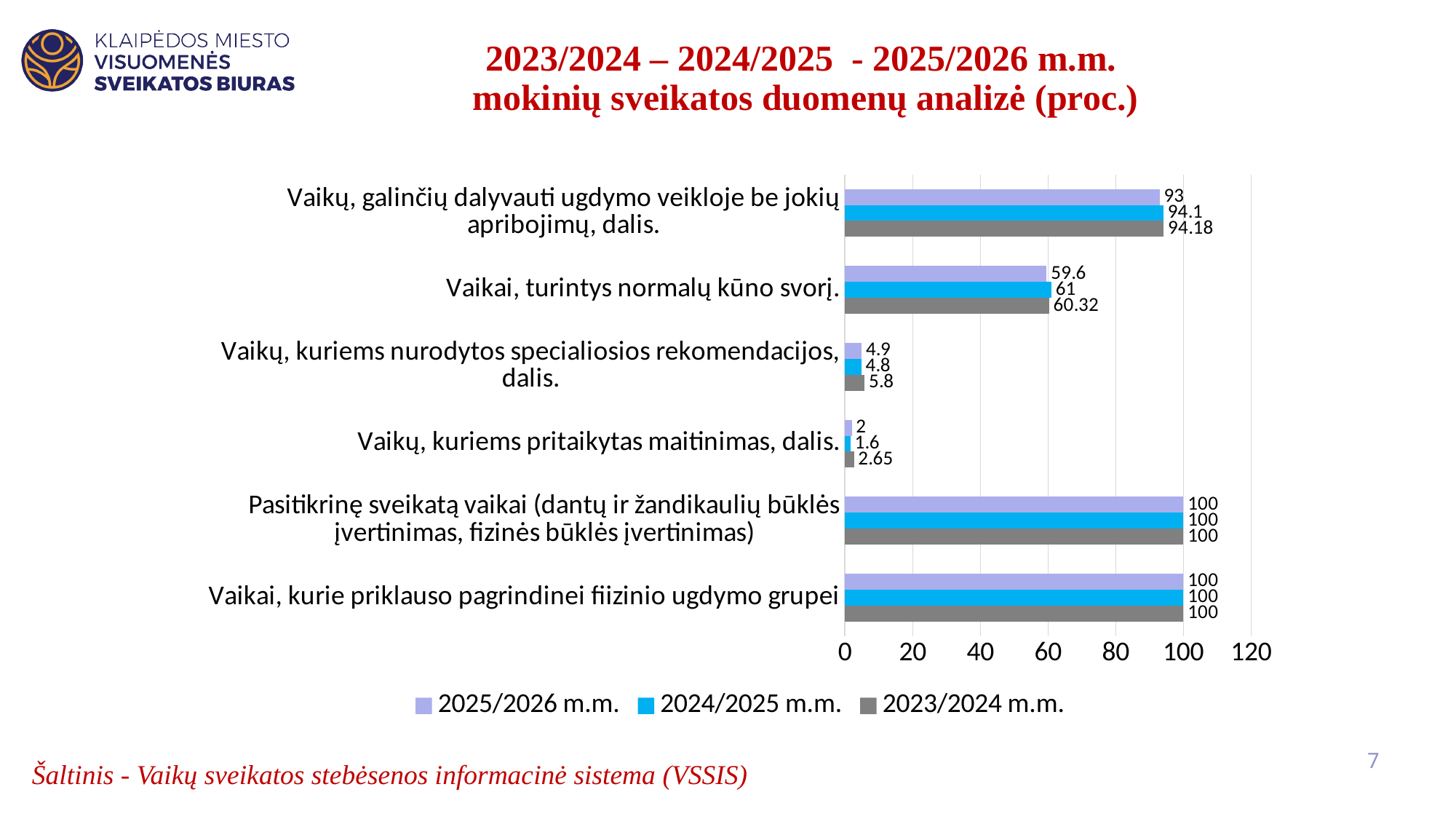
How many series does the legend list? 3 What is the 2025/2026 m.m. value for "Vaikų, kuriems pritaikytas maitinimas, dalis."? 2 What is the 2023/2024 m.m. value for "Vaikų, kuriems nurodytos specialiosios rekomendacijos, dalis."? 5.8 Is the 2025/2026 m.m. value for "Vaikų, galinčių dalyvauti ugdymo veikloje be jokių apribojimų, dalis." greater or less than 80? greater What is the 2023/2024 m.m. value for "Vaikų, galinčių dalyvauti ugdymo veikloje be jokių apribojimų, dalis."? 94.18 For "Vaikų, kuriems nurodytos specialiosios rekomendacijos, dalis.", what is the difference between the 2023/2024 m.m. value and the 2025/2026 m.m. value? 0.9 Which category has the lowest 2023/2024 m.m. value? Vaikų, kuriems pritaikytas maitinimas, dalis. How many categories are shown on the chart? 6 What kind of chart is shown on the slide? bar chart For "Vaikų, galinčių dalyvauti ugdymo veikloje be jokių apribojimų, dalis.", what is the difference between the 2023/2024 m.m. value and the 2025/2026 m.m. value? 1.18 For "Vaikai, turintys normalų kūno svorį.", which series has the larger value: 2024/2025 m.m. or 2025/2026 m.m.? 2024/2025 m.m. What is the 2024/2025 m.m. value for "Vaikai, turintys normalų kūno svorį."? 61